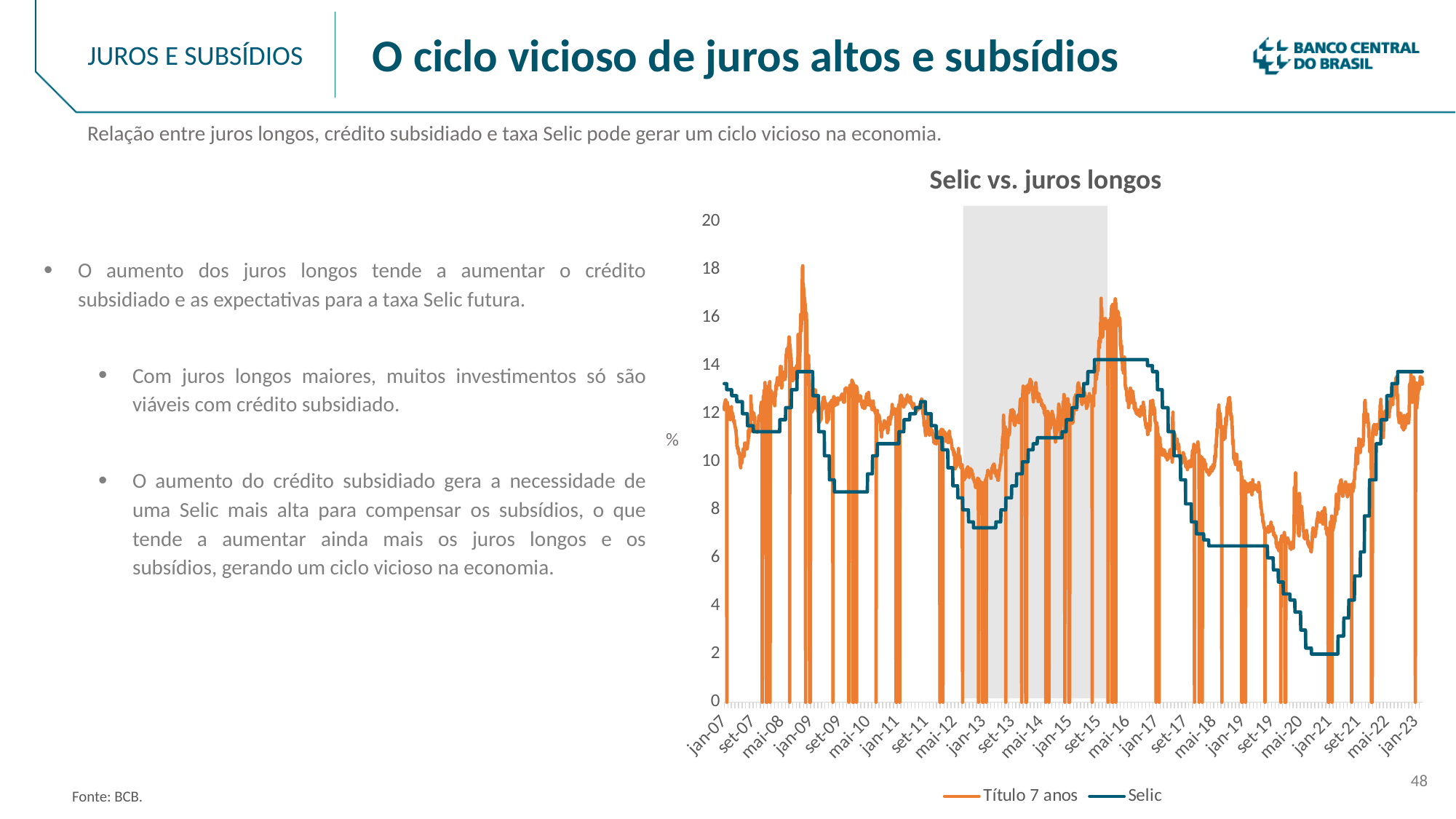
Is the Selic value at jan-07 greater or less than 12? greater What type of chart is shown on the slide? line chart How many series does the legend of the chart list? 2 Is the Título 7 anos value at jan-21 greater or less than 10? less Does the Selic line rise or fall between jan-16 and jan-18? fall Does the Selic line rise or fall between mai-20 and jan-23? rise At jan-21, which series has the higher value, Título 7 anos or Selic? Título 7 anos Is the Selic value at jan-21 greater or less than 4? less What is the title of the chart? Selic vs. juros longos What are the two series named in the chart legend? Título 7 anos and Selic